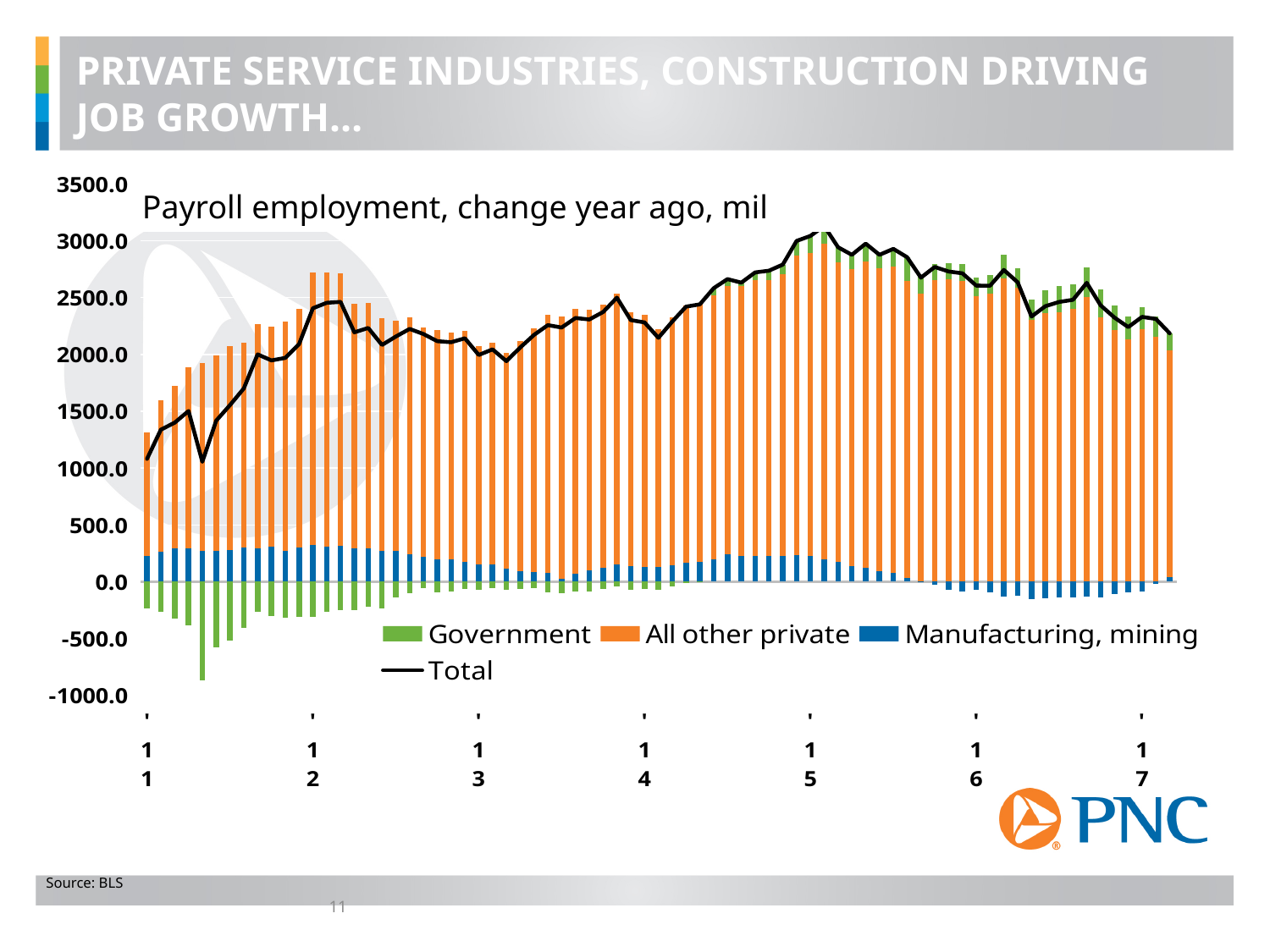
Is the Total value at the start of 13 greater or less than 2500.0? less Is the Total value at the start of 11 greater or less than 1500.0? less Around which x-axis label does the Total line reach its highest point? 15 Is the Total value at the end of the series (17) greater or less than 2000.0? greater What kind of chart is shown on the slide? Stacked bar chart with a line How many series does the legend list? 4 Which series is drawn as a line rather than bars? Total Does the Total line rise or fall from 15 to 17? fall Is the Total value at 15 larger or smaller than the Total value at 11? larger What is the title of the chart? Payroll employment, change year ago, mil Around which x-axis label does the Total line reach its lowest point? 11